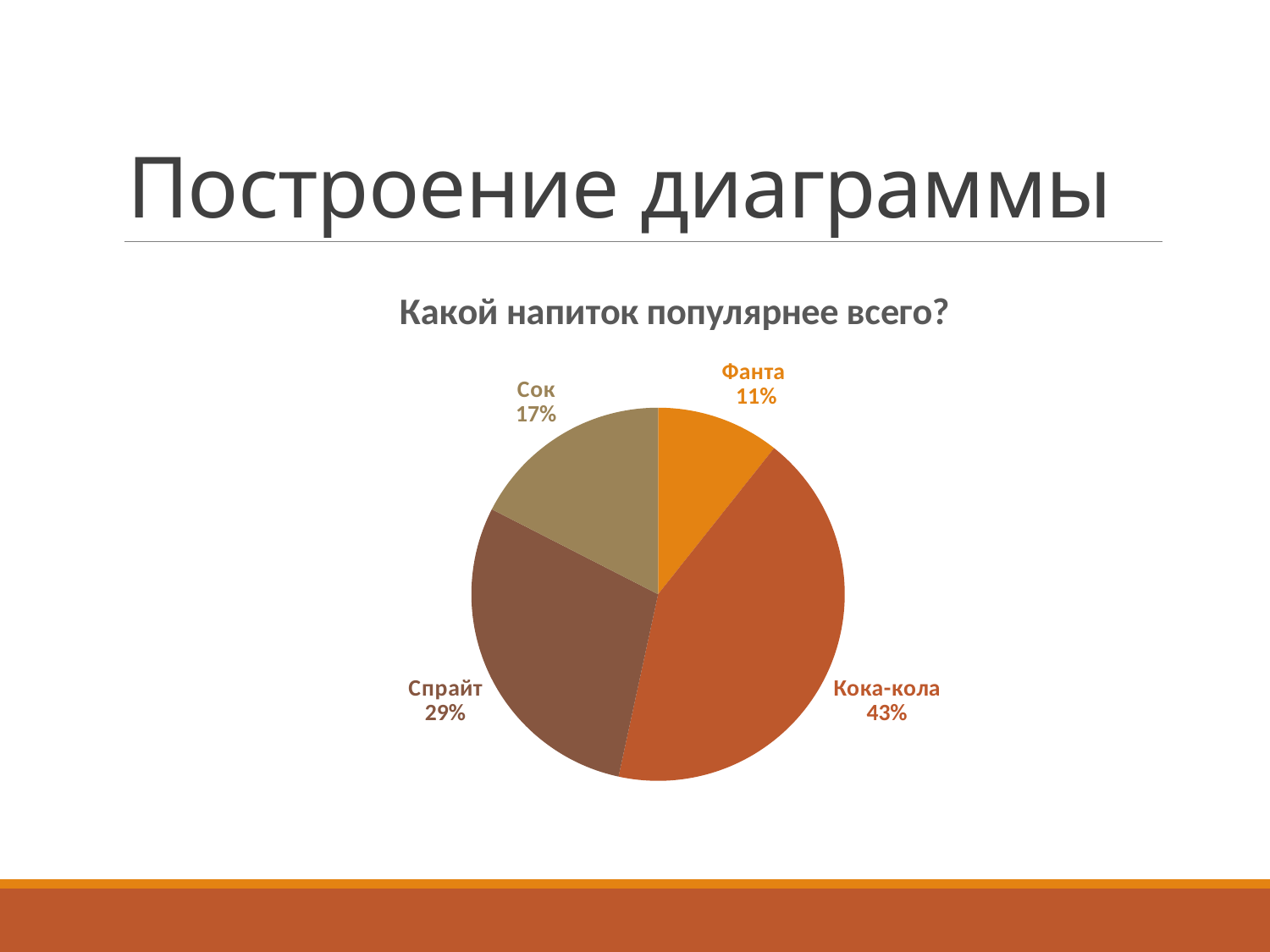
Which drink has the smallest slice of the pie? Фанта What share of the pie does Спрайт have? 29% What share of the pie does Кока-кола have? 43% What is the chart's title? Какой напиток популярнее всего? What share of the pie does Сок have? 17% Which has a larger share, Сок or Фанта? Сок What is the difference in percentage points between Спрайт and Сок? 12% What is the difference in percentage points between Кока-кола and Спрайт? 14% Which drink has the largest slice of the pie? Кока-кола What kind of chart is shown on the slide? pie chart How many slices does the pie chart have? 4